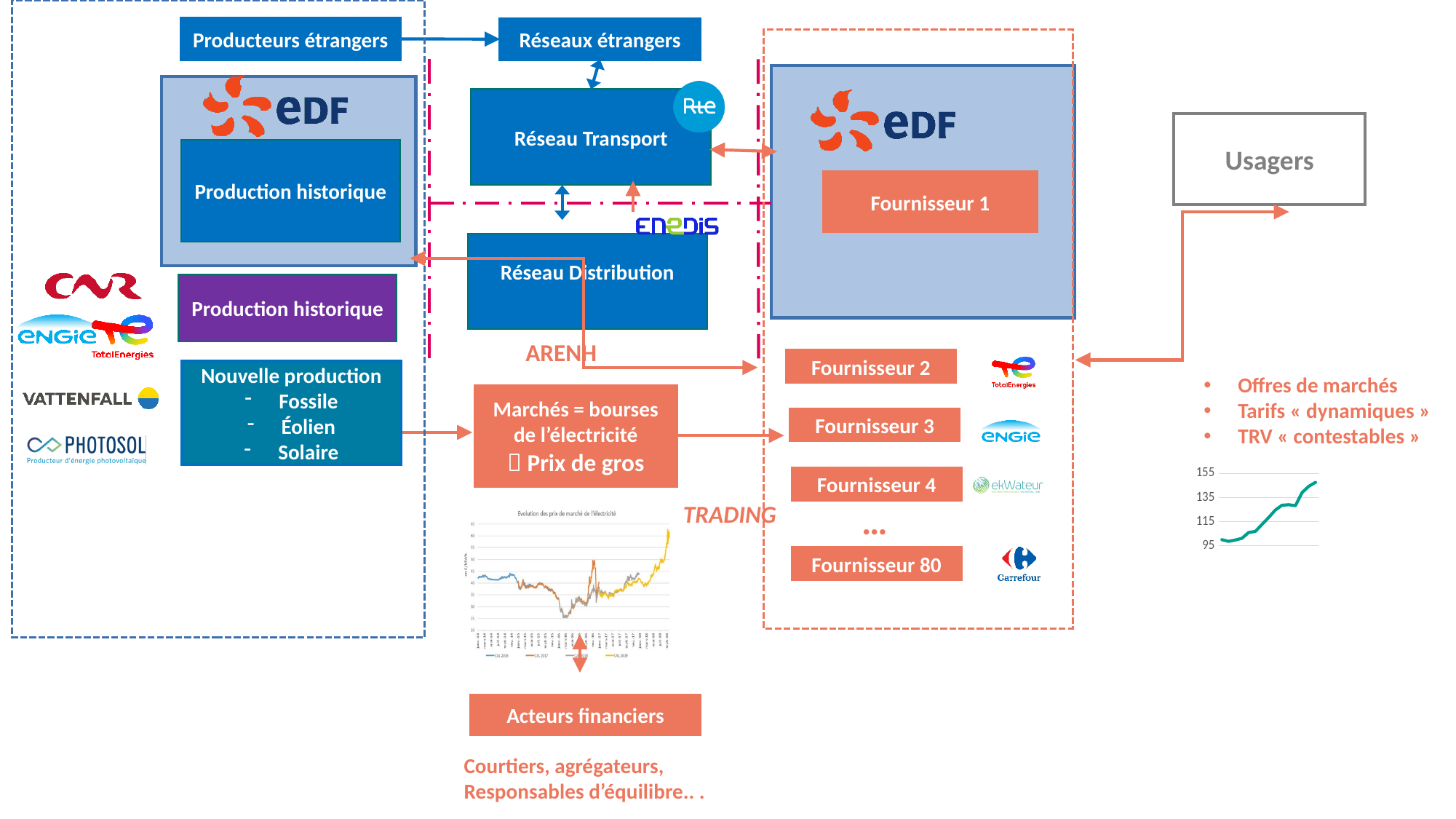
In the chart titled "Evolution des prix de marché de l'électricité", how many series does the legend list? 4 In the small chart on the right of the slide, what is the lowest tick value shown on the y axis? 95 What is the title of the chart at the bottom centre of the slide? Evolution des prix de marché de l'électricité In the small chart on the right of the slide with y-axis ticks 95 to 155, how many lines are plotted? 1 In the small chart on the right of the slide with y-axis ticks 95 to 155, is the value at the right end of the line greater or less than 135? greater In the chart titled "Evolution des prix de marché de l'électricité", does the yellow line rise or fall towards the right end of the x axis? rise In the small chart on the right of the slide with y-axis ticks 95 to 155, is the value at the left end of the line greater or less than 115? less In the chart titled "Evolution des prix de marché de l'électricité", what is the highest value shown on the y axis? 65 In the small chart on the right of the slide with y-axis ticks 95 to 155, do the values rise or fall along the x axis? rise What kind of chart is the small chart at the bottom centre of the slide, titled "Evolution des prix de marché de l'électricité"? line chart What kind of chart is the small chart on the right of the slide, below the bullet list, with y-axis ticks 95, 115, 135 and 155? line chart